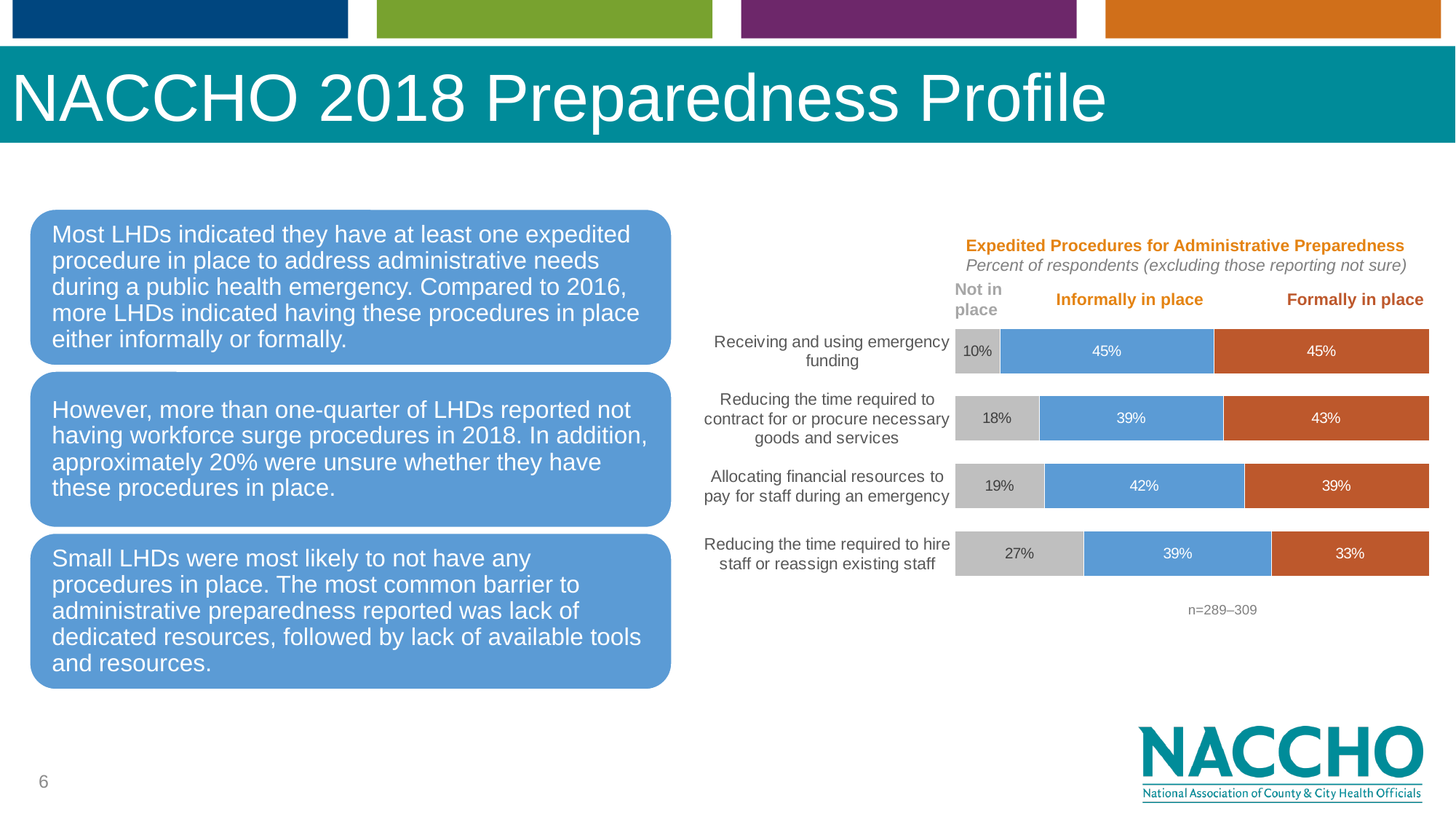
For 'Allocating financial resources to pay for staff during an emergency', which is larger: 'Informally in place' or 'Formally in place'? Informally in place What is the title of the chart? Expedited Procedures for Administrative Preparedness What type of chart is shown on the slide? Stacked bar chart How many procedures (categories) are shown in the chart? 4 Which procedure has the lowest 'Formally in place' percentage? Reducing the time required to hire staff or reassign existing staff Which procedure has the highest 'Not in place' percentage? Reducing the time required to hire staff or reassign existing staff How many series (response categories) does the chart show? 3 What percentage of respondents reported 'Formally in place' for 'Receiving and using emergency funding'? 45% Which procedure has the lowest 'Not in place' percentage? Receiving and using emergency funding What is the difference between the 'Formally in place' percentages for 'Receiving and using emergency funding' and 'Reducing the time required to hire staff or reassign existing staff'? 12% What percentage of respondents reported 'Not in place' for 'Reducing the time required to hire staff or reassign existing staff'? 27% What percentage of respondents reported 'Informally in place' for 'Allocating financial resources to pay for staff during an emergency'? 42%